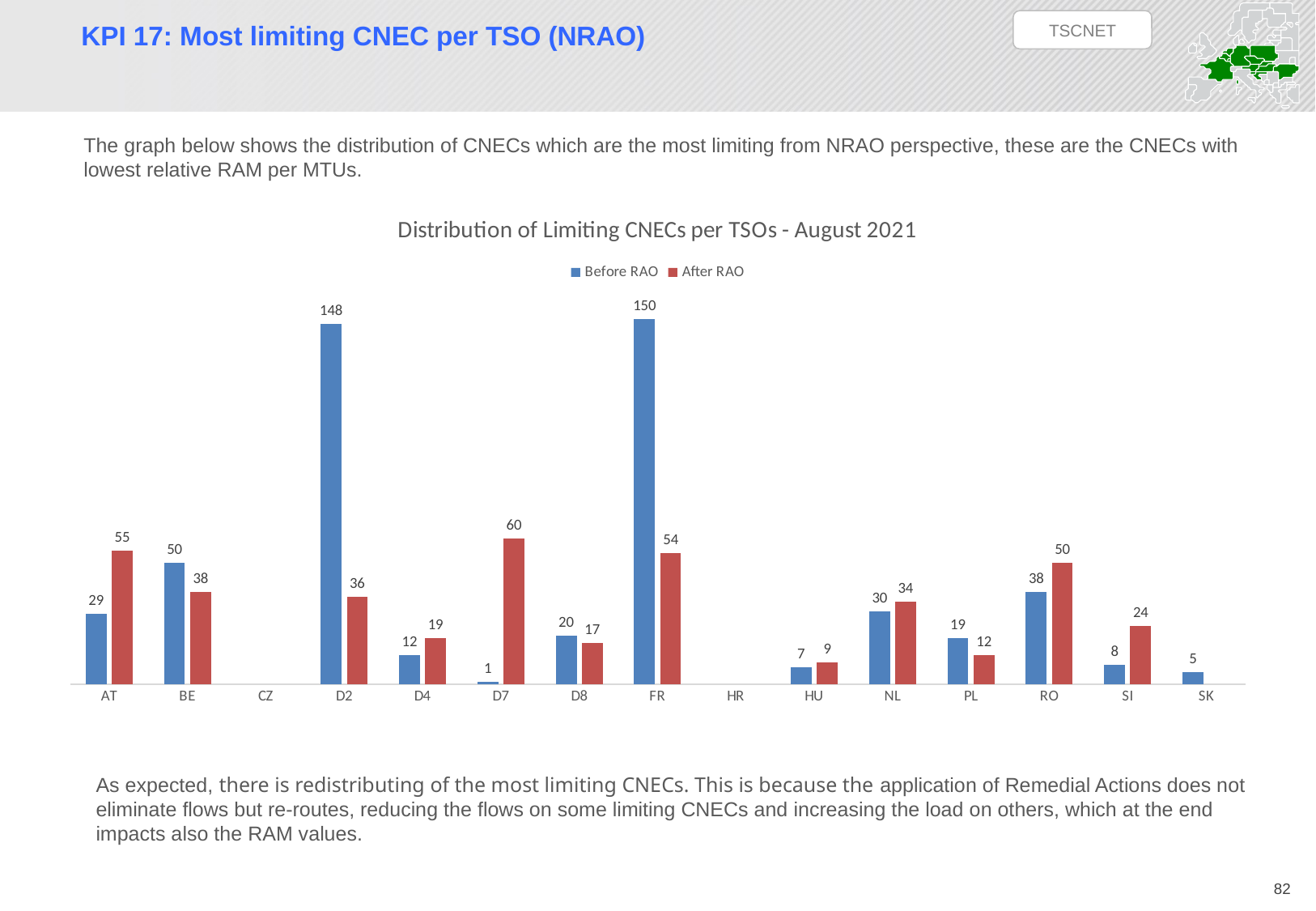
Which TSO has the highest Before RAO value? FR What is the After RAO value for D7? 60 For PL, which is larger: the Before RAO value or the After RAO value? Before RAO For RO, which is larger: the Before RAO value or the After RAO value? After RAO What type of chart is shown on the slide? Bar chart Which TSO has the highest After RAO value? D7 What is the difference between the After RAO values for AT and BE? 17 What is the difference between the Before RAO and After RAO values for FR? 96 How many series does the legend list? 2 How many TSO categories are shown on the x axis? 15 What is the After RAO value for SI? 24 What is the Before RAO value for D2? 148